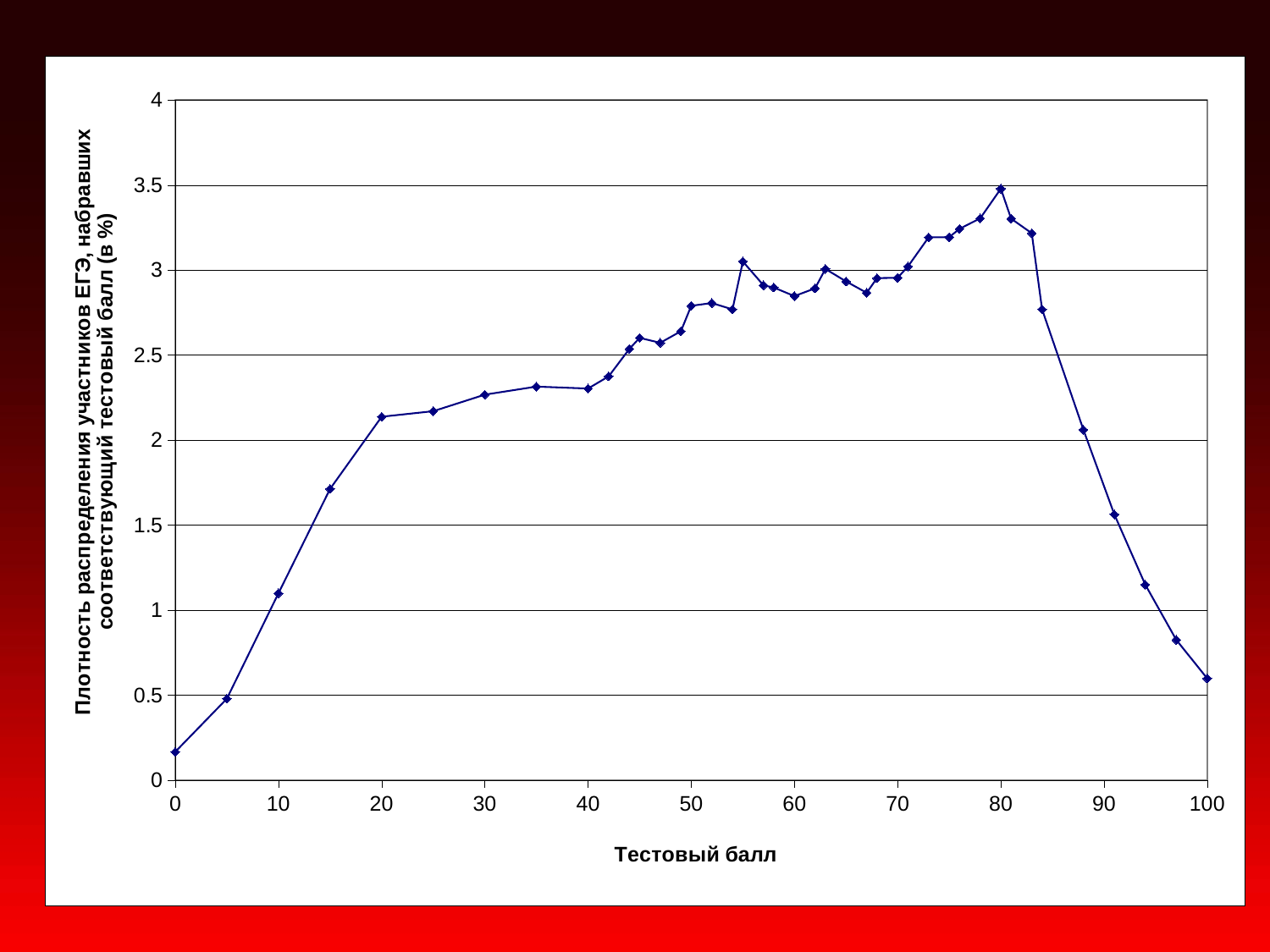
What is the title of the x axis of the chart? Тестовый балл Is the value for test score 5 greater or less than 1? less At which test score (Тестовый балл) does the plotted density reach its highest value? 80 Is the value for test score 10 greater or less than 1.5? less Is the value for test score 80 greater or less than 3? greater Do the values rise or fall as the test score goes from 80 to 100? fall At which test score (Тестовый балл) is the plotted density lowest? 0 What kind of chart is shown on the slide? line chart Do the values rise or fall as the test score goes from 0 to 20? rise Which has the larger value: test score 0 or test score 100? 100